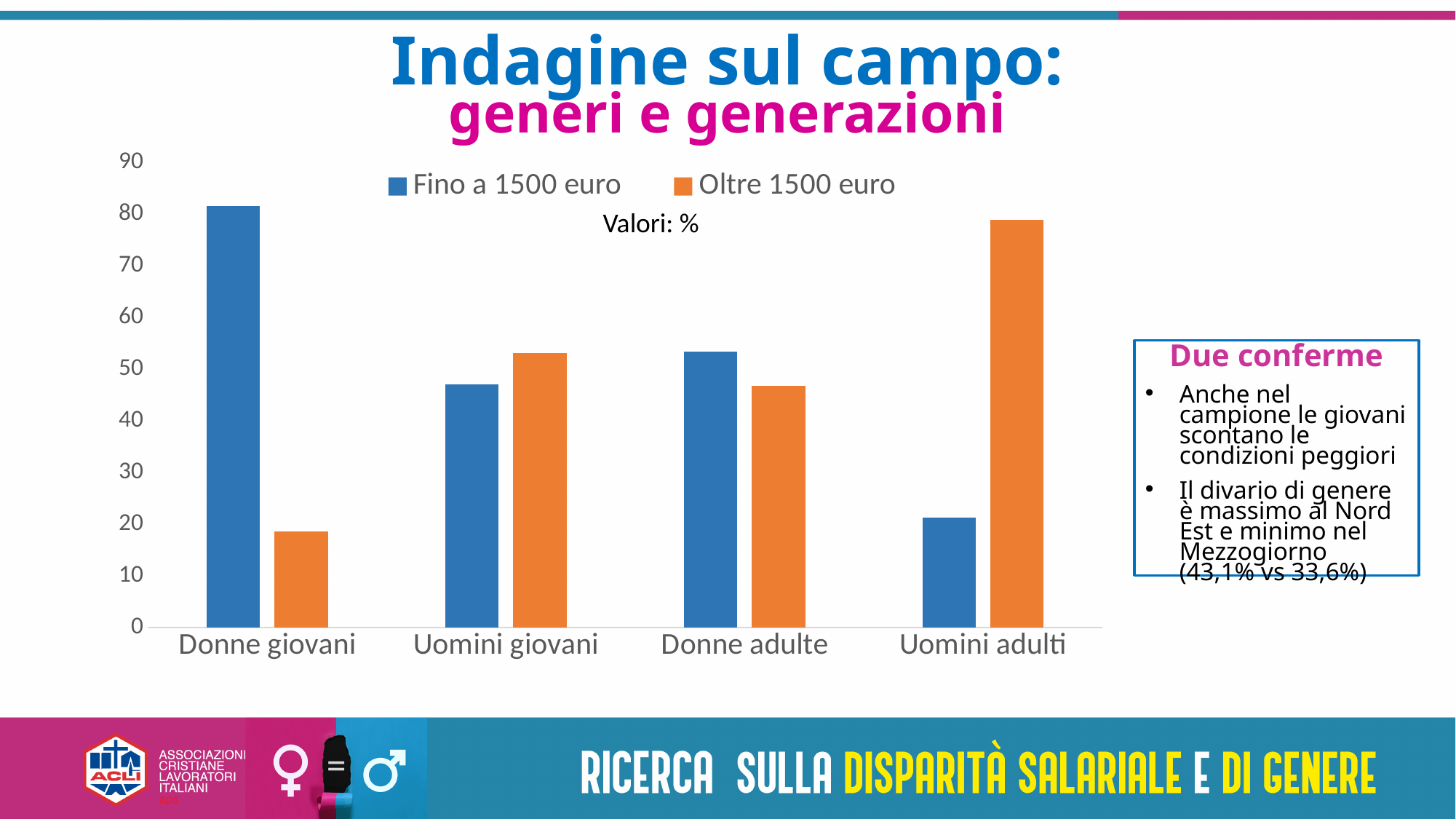
How many series does the chart legend list? 2 What kind of chart is shown on the slide? bar chart Is the 'Oltre 1500 euro' value for 'Donne giovani' greater or less than 30? less Which category has the highest value for the 'Fino a 1500 euro' series? Donne giovani Which category has the lowest value for the 'Oltre 1500 euro' series? Donne giovani Which category has the highest value for the 'Oltre 1500 euro' series? Uomini adulti How many categories are shown on the x axis of the chart? 4 Which category has the lowest value for the 'Fino a 1500 euro' series? Uomini adulti For 'Uomini adulti', which series has the larger value, 'Fino a 1500 euro' or 'Oltre 1500 euro'? Oltre 1500 euro What colour are the bars for the 'Oltre 1500 euro' series? orange Is the 'Fino a 1500 euro' value for 'Donne giovani' greater or less than 70? greater For 'Donne giovani', which series has the larger value, 'Fino a 1500 euro' or 'Oltre 1500 euro'? Fino a 1500 euro